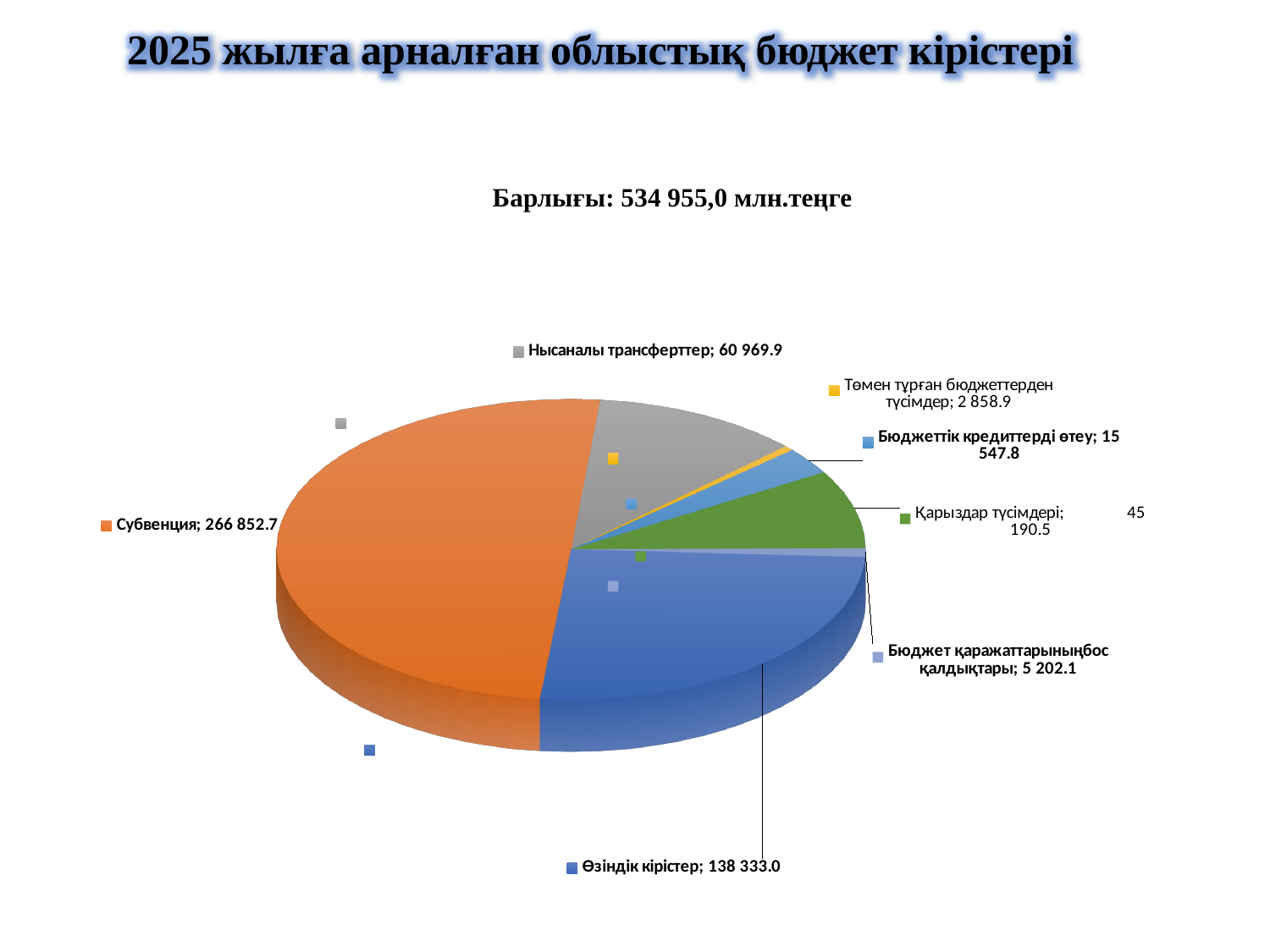
Which category has the smallest value? Төмен тұрған бюджеттерден түсімдер What is the value for Өзіндік кірістер? 138 333.0 What is the value for Нысаналы трансферттер? 60 969.9 Which is larger: Қарыздар түсімдері or Бюджеттік кредиттерді өтеу? Қарыздар түсімдері What is the difference between the values for Субвенция and Өзіндік кірістер? 128 519.7 What total amount is stated above the chart (Барлығы)? 534 955,0 млн.теңге Which category has the largest value? Субвенция What kind of chart is shown on the slide? pie chart What is the value for Субвенция? 266 852.7 What is the value for Бюджеттік кредиттерді өтеу? 15 547.8 What is the value for Бюджет қаражаттарының бос қалдықтары? 5 202.1 How many categories (slices) does the pie chart have? 7